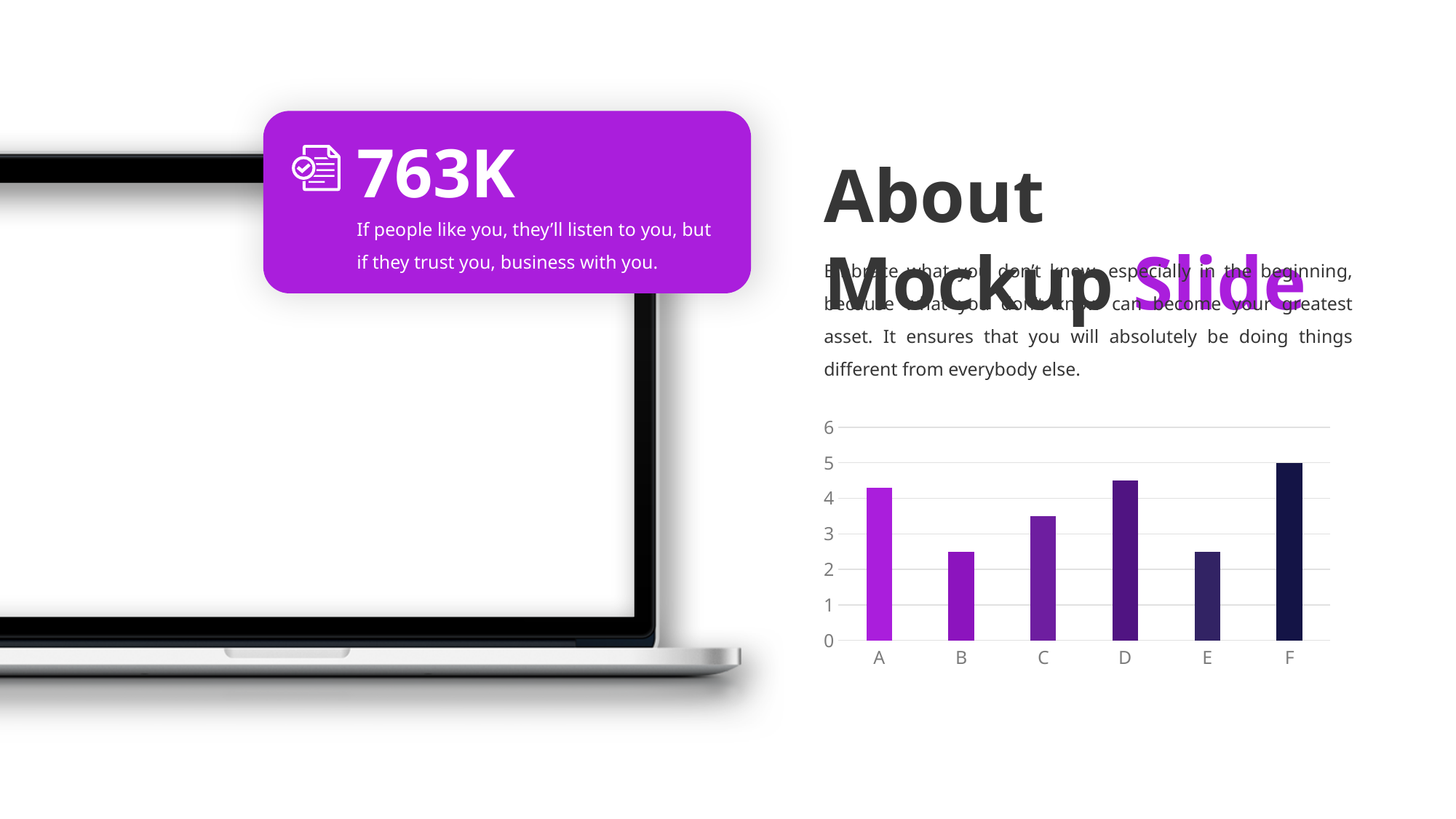
How many categories are shown on the x axis of the bar chart? 6 What is the value for category F in the bar chart? 5 Is the value for D greater or less than 5? less Is the value for C greater or less than 3? greater Is the value for E greater or less than 2? greater What kind of chart is shown on the slide? bar chart Which category has the highest bar in the chart? F What is the highest value shown on the y axis of the chart? 6 Which is larger, the value for C or the value for D? D Which is larger, the value for A or the value for B? A